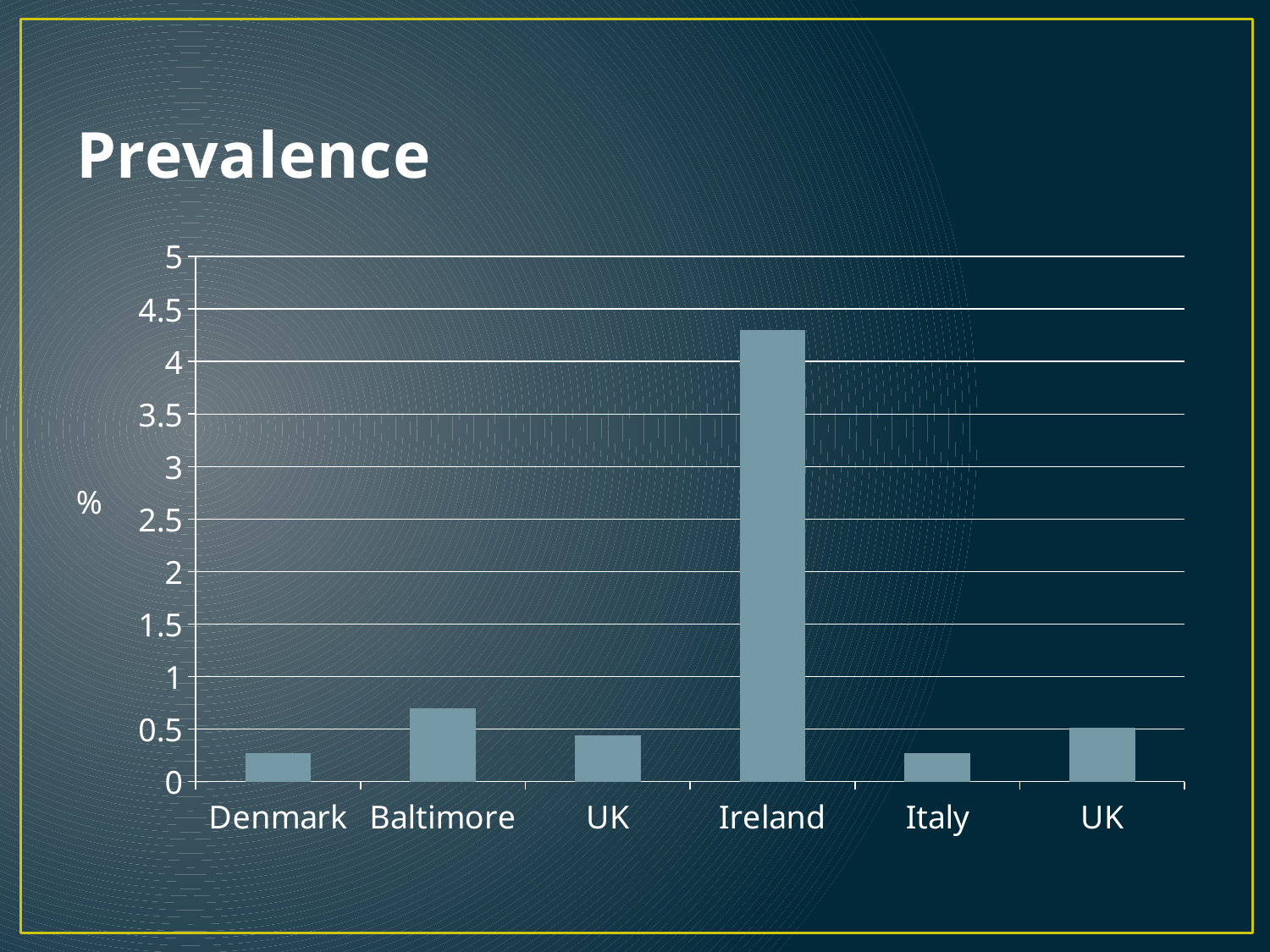
What is the title of the chart? Prevalence Which is larger, the value for Baltimore or the value for Denmark? Baltimore What type of chart is shown on the slide? bar chart Is the value for Denmark greater or less than 0.5? less Is the value for Italy greater or less than 0.5? less How many bars are plotted in the chart? 6 Which is larger, the value for Ireland or the value for Baltimore? Ireland Is the value for Ireland greater or less than 4? greater Which category has the highest prevalence? Ireland What is the label on the vertical axis? %